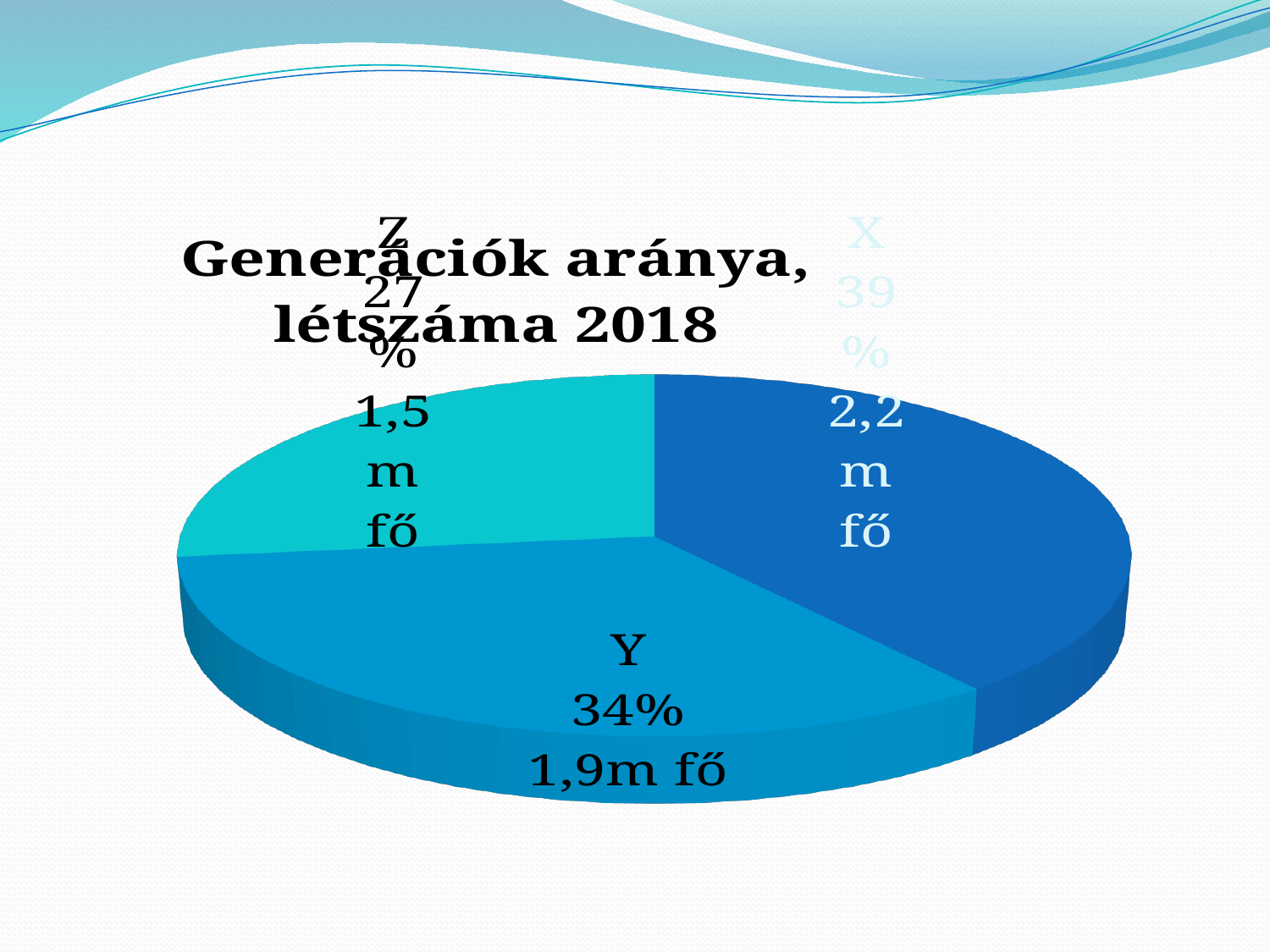
How many people (fő) are in generation X according to the chart? 2,2m fő How many slices does the pie chart have? 3 How many people (fő) are in generation Y according to the chart? 1,9m fő What percentage share does generation Y have in the pie chart? 34% What is the title of the chart? Generációk aránya, létszáma 2018 Which generation has the smallest slice of the pie? Z What kind of chart is shown on the slide? pie chart What percentage share does generation Z have in the pie chart? 27% How many people (fő) are in generation Z according to the chart? 1,5m fő What percentage share does generation X have in the pie chart? 39% Which generation has a larger share, Y or Z? Y Which generation has the largest slice of the pie? X